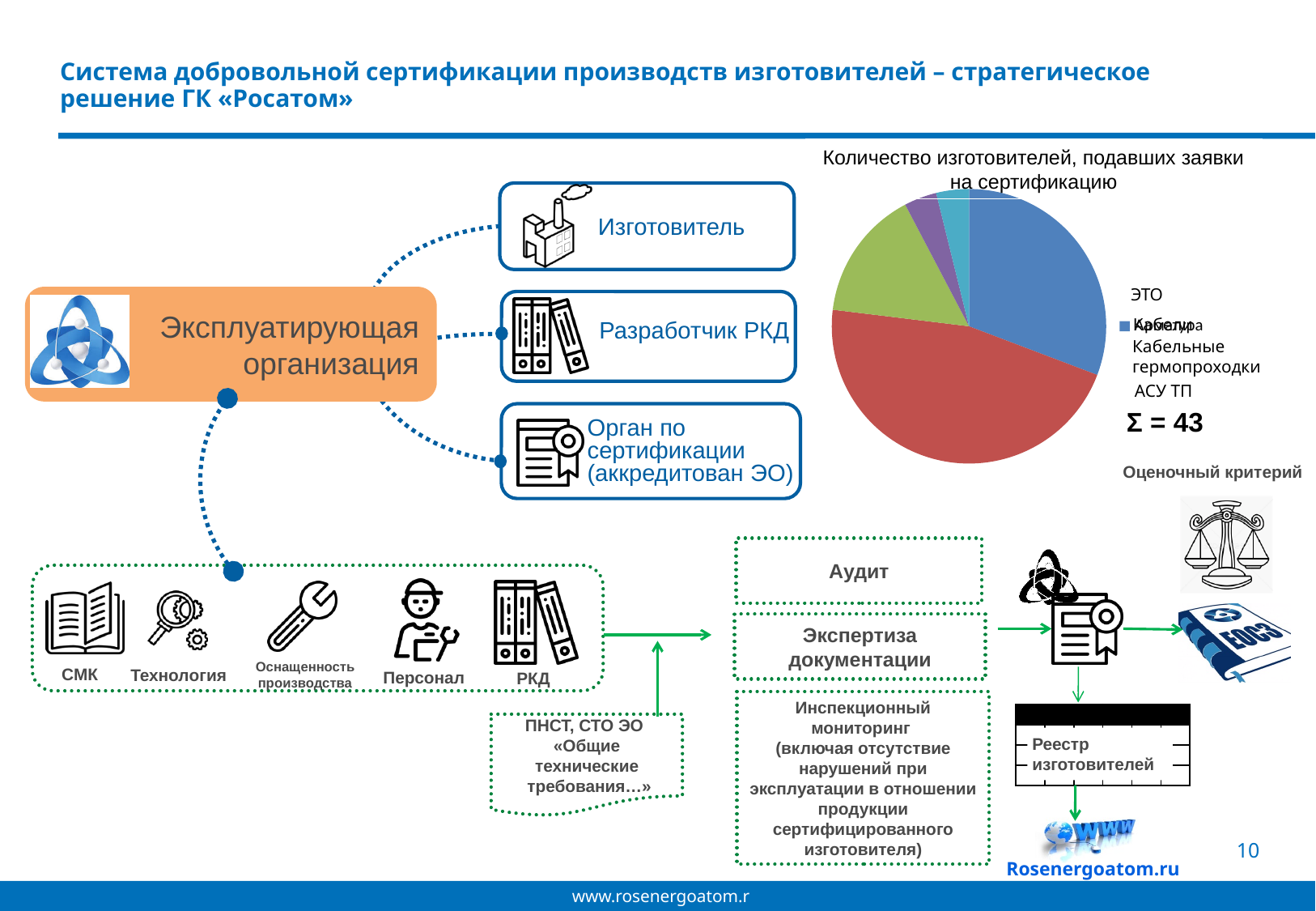
What is the title of the pie chart? Количество изготовителей, подавших заявки на сертификацию What total is printed next to the pie chart? Σ = 43 How many slices does the pie chart have? 5 In the pie chart, which slice is larger, the blue one or the green one? blue Which colour slice is the largest in the pie chart? red Which entry is listed last in the pie chart's legend? АСУ ТП In the pie chart, which slice is larger, the red one or the blue one? red What kind of chart is shown on the slide? pie chart